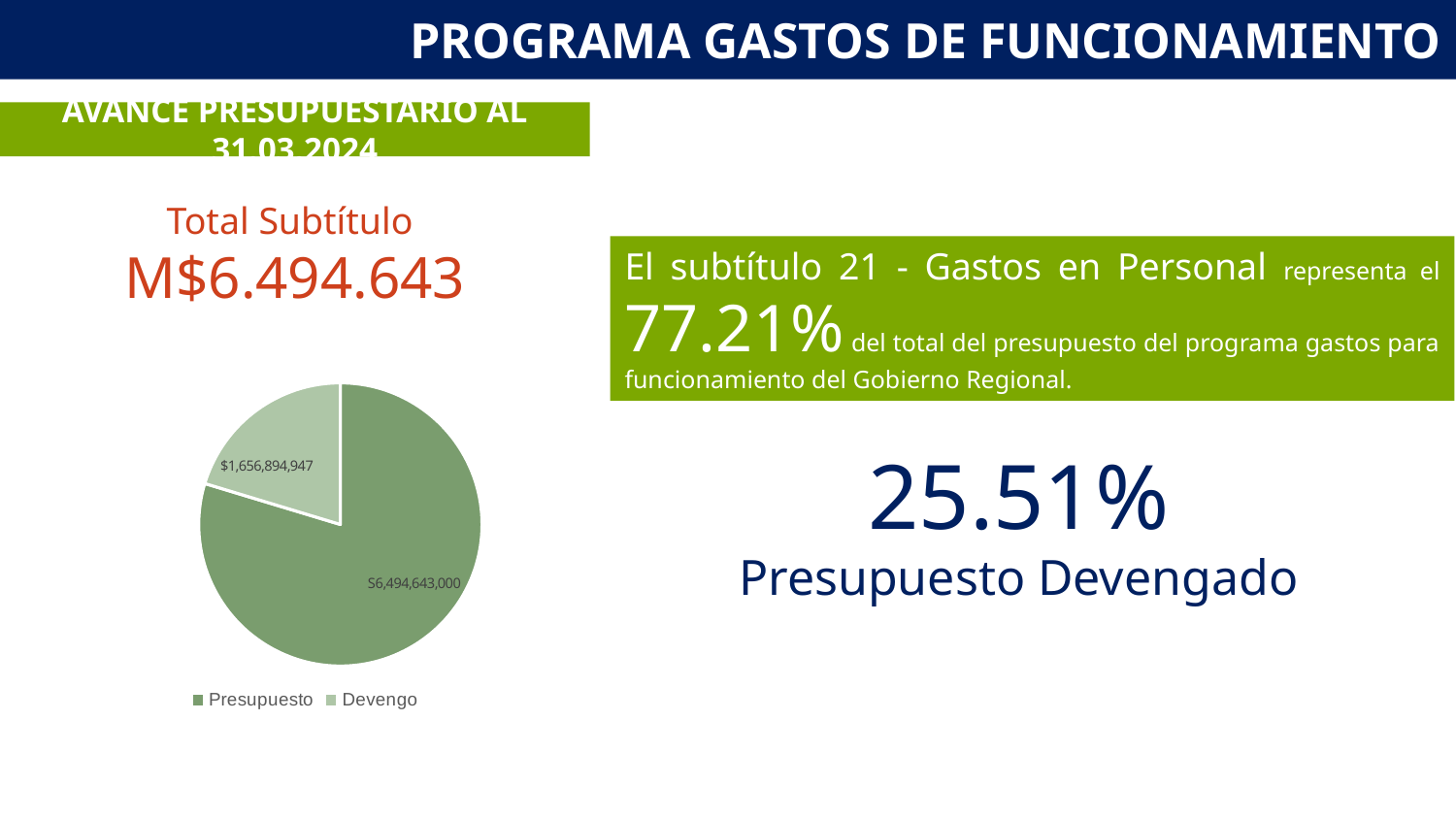
How many entries does the pie chart's legend list? 2 Which legend entry of the pie chart is shown in the darker green colour? Presupuesto Which is larger in the pie chart, Presupuesto or Devengo? Presupuesto What value is shown for the Presupuesto slice of the pie chart? $6,494,643,000 What type of chart is shown on the slide? Pie chart What is the difference between the Presupuesto value and the Devengo value in the pie chart? $4,837,748,053 Which slice of the pie chart is the largest? Presupuesto Which slice of the pie chart is the smallest? Devengo How many slices does the pie chart have? 2 What value is shown for the Devengo slice of the pie chart? $1,656,894,947 What are the two legend entries of the pie chart? Presupuesto and Devengo